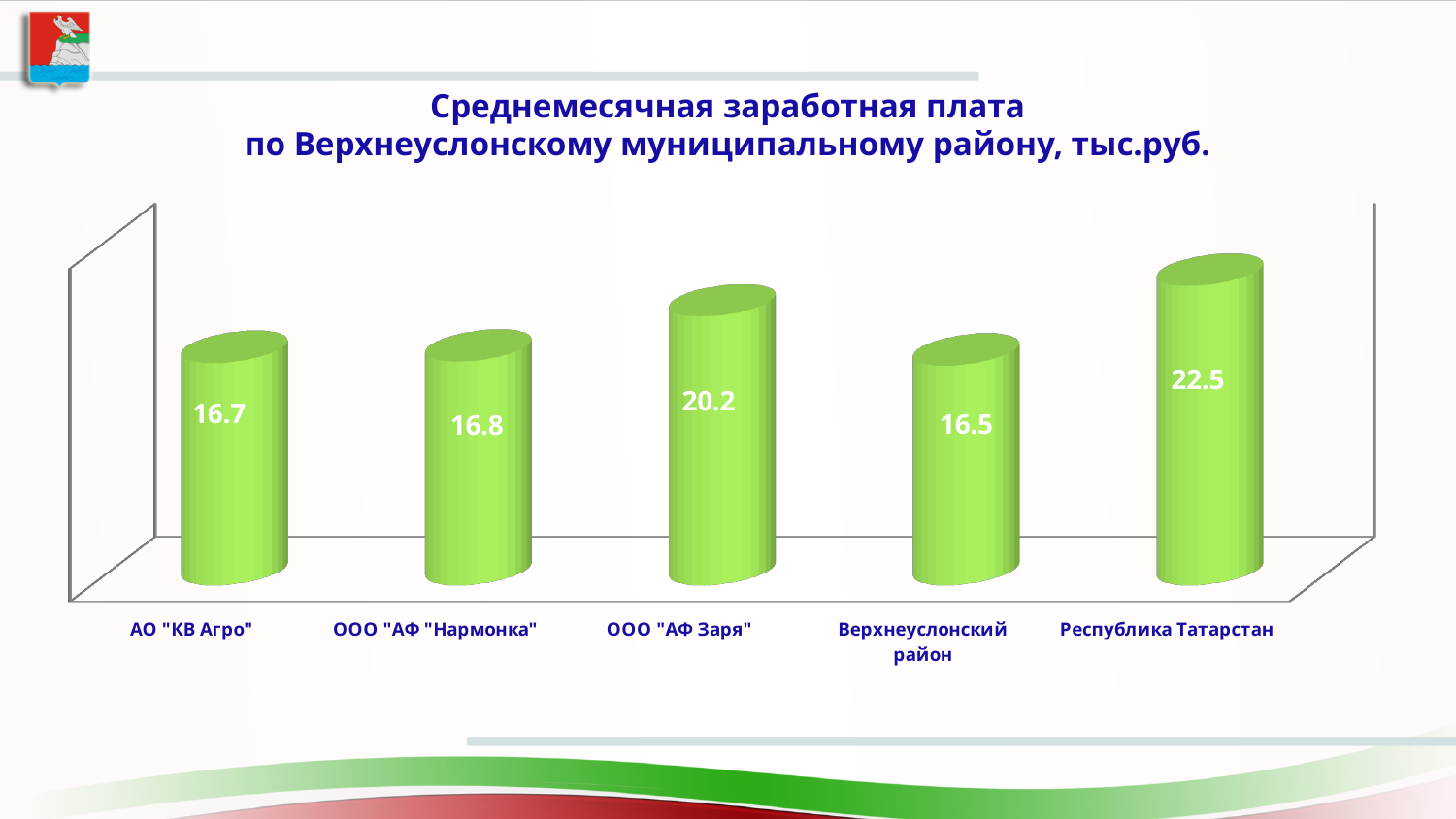
Which category has the lowest value? Верхнеуслонский район Which category has the highest value? Республика Татарстан What kind of chart is shown on the slide? bar chart What unit is stated in the chart title? тыс.руб. What is the value for Республика Татарстан? 22.5 How many categories are shown in the chart? 5 What is the value for АО "КВ Агро"? 16.7 What is the value for Верхнеуслонский район? 16.5 Which is larger, the value for ООО "АФ Заря" or the value for АО "КВ Агро"? ООО "АФ Заря" What is the difference between the values for Республика Татарстан and Верхнеуслонский район? 6.0 What is the difference between the values for ООО "АФ Заря" and ООО "АФ "Нармонка"? 3.4 What is the value for ООО "АФ Заря"? 20.2